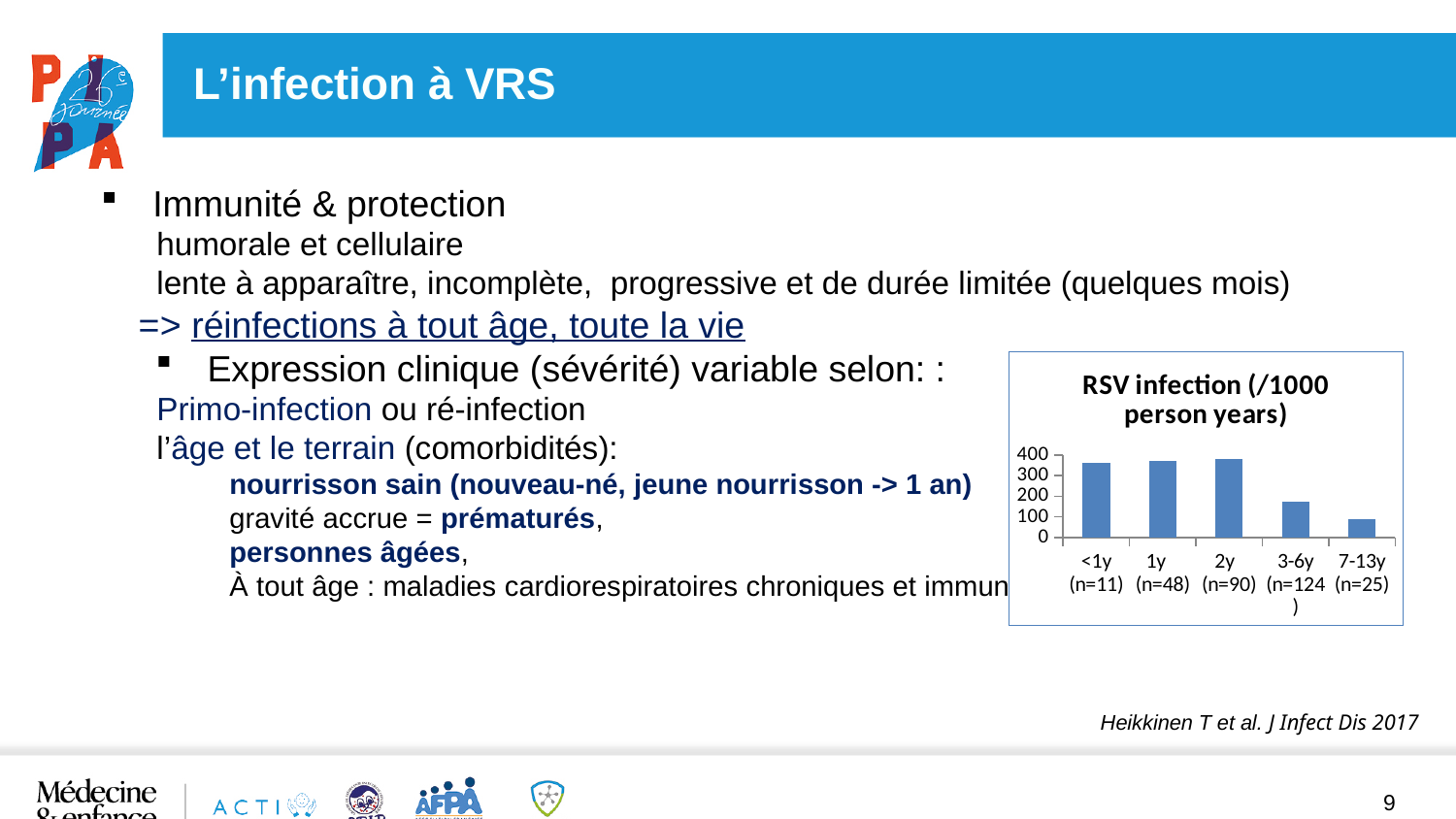
Is the value for 2y (n=90) greater or less than 300? greater Which is larger, the value for 3-6y (n=124) or the value for 7-13y (n=25)? 3-6y (n=124) Do the values rise or fall from the 2y category to the 7-13y category? fall Is the value for 3-6y (n=124) greater or less than 100? greater Which is larger, the value for 2y (n=90) or the value for 3-6y (n=124)? 2y (n=90) Is the value for 3-6y (n=124) greater or less than 200? less How many age categories are shown on the x axis of the chart? 5 Which age category has the lowest RSV infection rate? 7-13y (n=25) What is the title of the chart? RSV infection (/1000 person years) What kind of chart is shown on the slide? bar chart